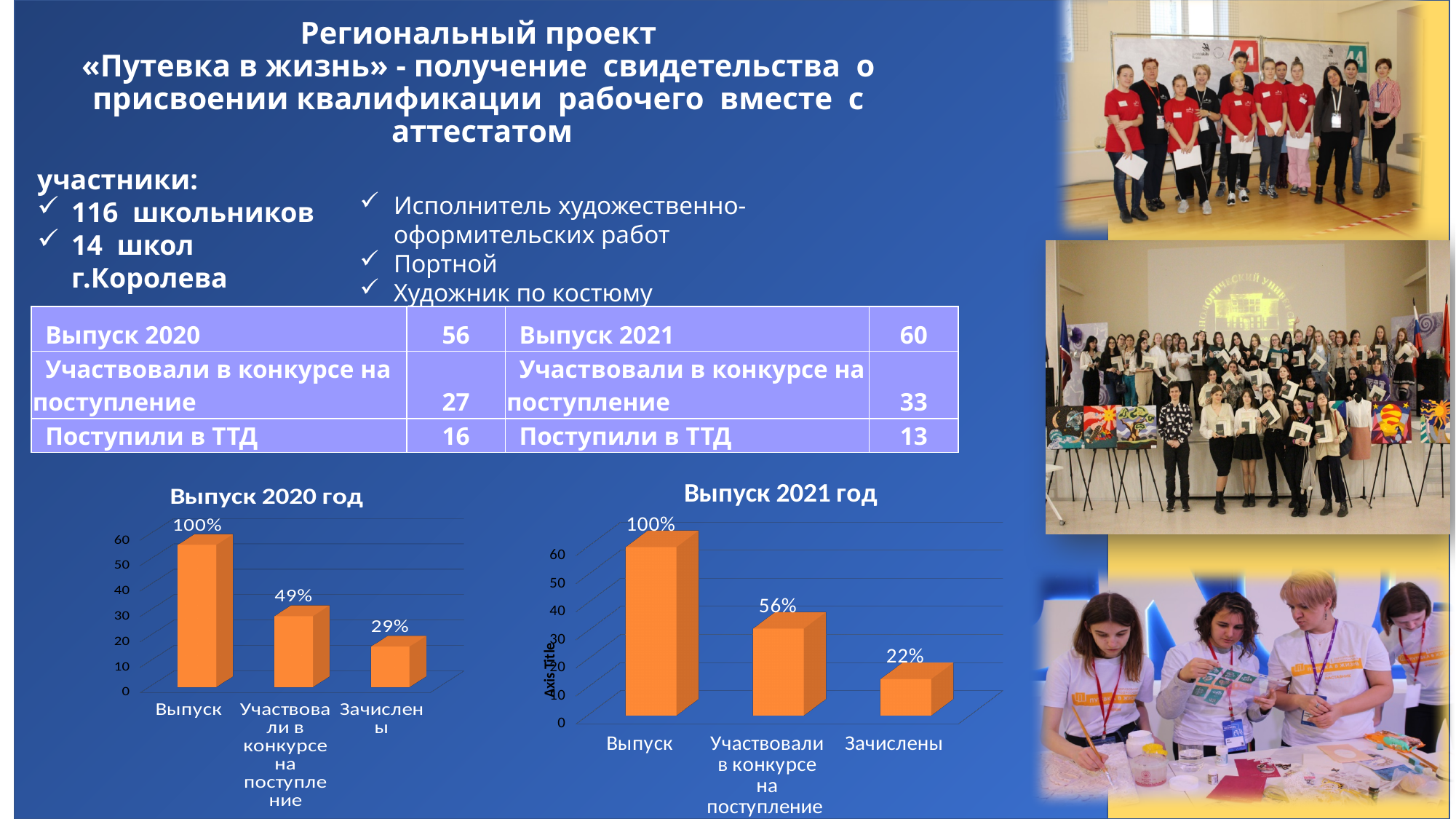
In the chart titled 'Выпуск 2020 год', what is the data label on the bar for 'Зачислены'? 29% In the chart titled 'Выпуск 2021 год', what is the data label on the bar for 'Зачислены'? 22% In the chart titled 'Выпуск 2021 год', what is the data label on the bar for 'Участвовали в конкурсе на поступление'? 56% In the chart titled 'Выпуск 2020 год', which category has the highest value? Выпуск Which is larger: the 'Зачислены' label in the 'Выпуск 2020 год' chart or the 'Зачислены' label in the 'Выпуск 2021 год' chart? Выпуск 2020 год In the chart titled 'Выпуск 2021 год', do the values rise or fall from left to right along the x axis? fall What kind of chart is 'Выпуск 2020 год'? bar chart How many categories are shown in the chart titled 'Выпуск 2021 год'? 3 In the chart titled 'Выпуск 2020 год', what is the data label on the bar for 'Участвовали в конкурсе на поступление'? 49% In the chart titled 'Выпуск 2020 год', is the bar for 'Зачислены' greater or less than 20 on the vertical axis? less In the chart titled 'Выпуск 2020 год', what is the difference in percentage points between the labels for 'Участвовали в конкурсе на поступление' and 'Зачислены'? 20 In the chart titled 'Выпуск 2021 год', which category has the lowest value? Зачислены